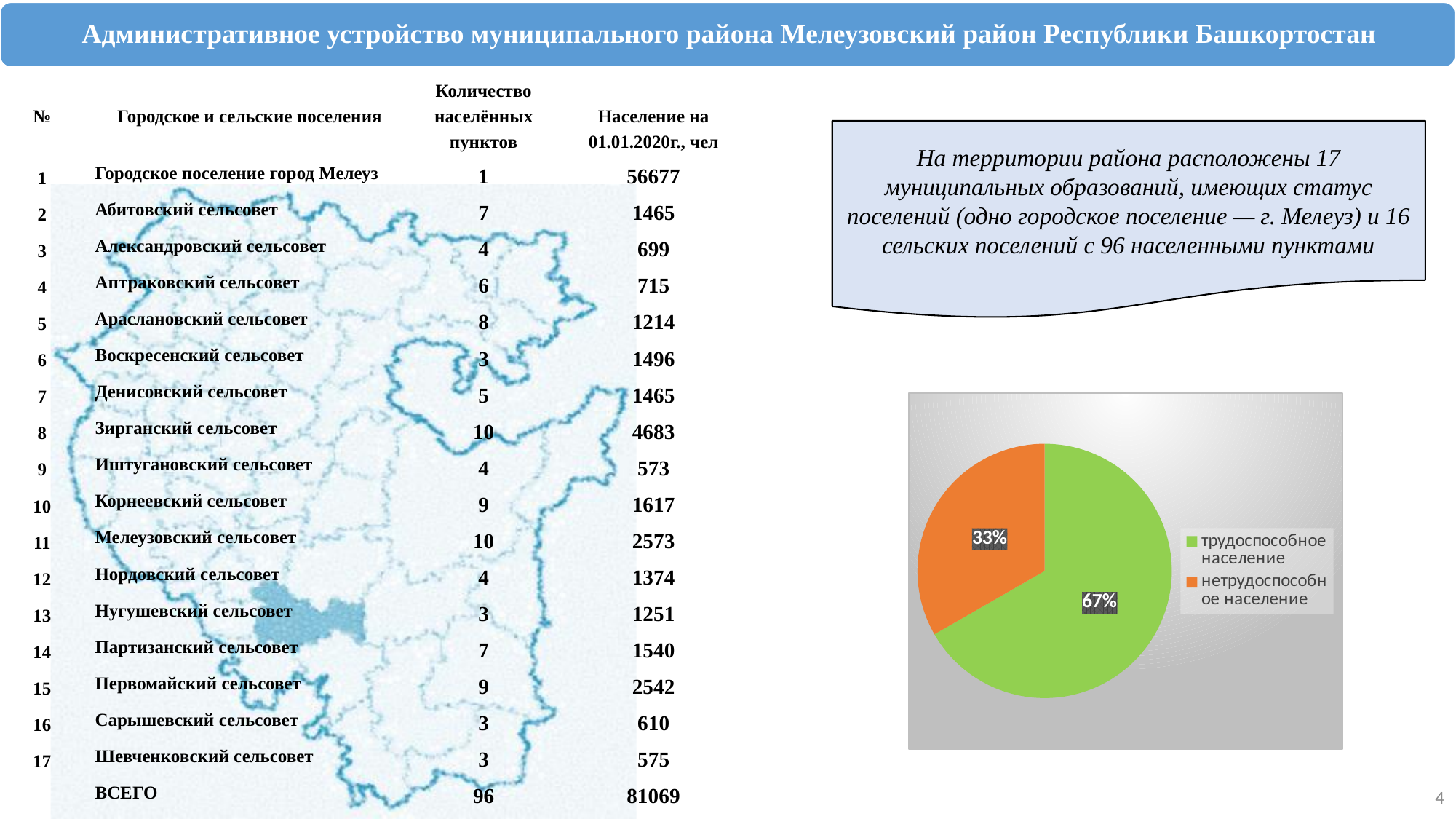
In the pie chart, which is larger: трудоспособное население or нетрудоспособное население? трудоспособное население How many entries does the legend of the pie chart list? 2 In the pie chart, what share is shown for нетрудоспособное население? 33% In the pie chart, what share is shown for трудоспособное население? 67% Which slice of the pie chart is the smallest? нетрудоспособное население How many slices does the pie chart have? 2 What colour is the slice for нетрудоспособное население in the pie chart? orange Is the share for нетрудоспособное население in the pie chart greater or less than 50%? less Which slice of the pie chart is the largest? трудоспособное население What kind of chart is shown on the right side of the slide? pie chart What colour is the slice for трудоспособное население in the pie chart? green By how many percentage points does трудоспособное население exceed нетрудоспособное население in the pie chart? 34